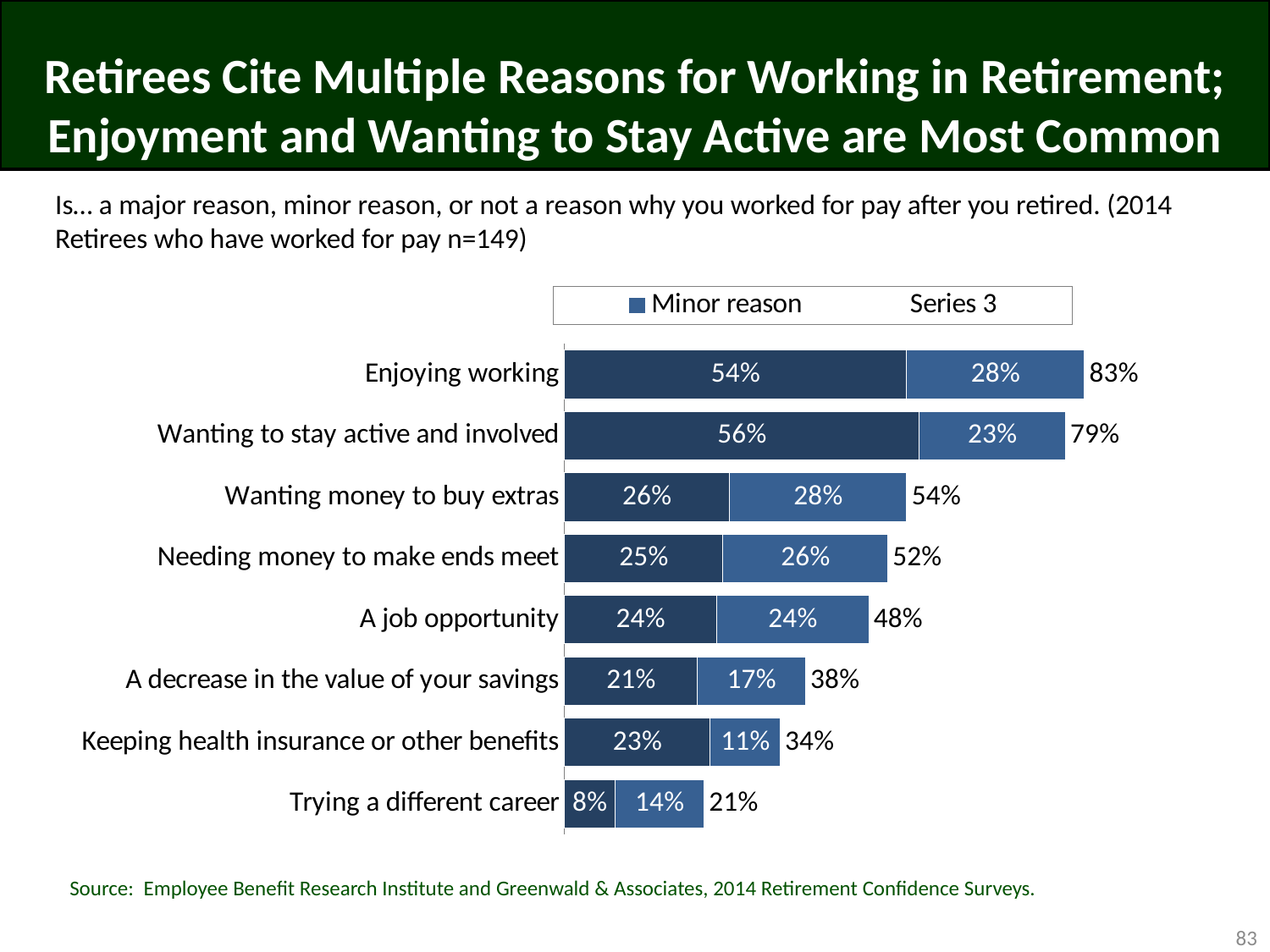
What is the second entry listed in the chart legend? Series 3 Which reason has the highest total value? Enjoying working What is the difference between the "Minor reason" values for "A job opportunity" and "A decrease in the value of your savings"? 7% Which reason has the lowest total value? Trying a different career What is the "Minor reason" value for "Keeping health insurance or other benefits"? 11% What is the difference between the total for "Enjoying working" and the total for "Wanting to stay active and involved"? 4% What kind of chart is shown on the slide? Stacked bar chart What is the total value shown at the end of the bar for "Enjoying working"? 83% What is the "Minor reason" value for "Wanting to stay active and involved"? 23% What is the value of the dark blue segment for "Trying a different career"? 8% How many reasons (categories) are listed in the chart? 8 Which has a larger dark blue segment: "Enjoying working" or "Wanting to stay active and involved"? Wanting to stay active and involved